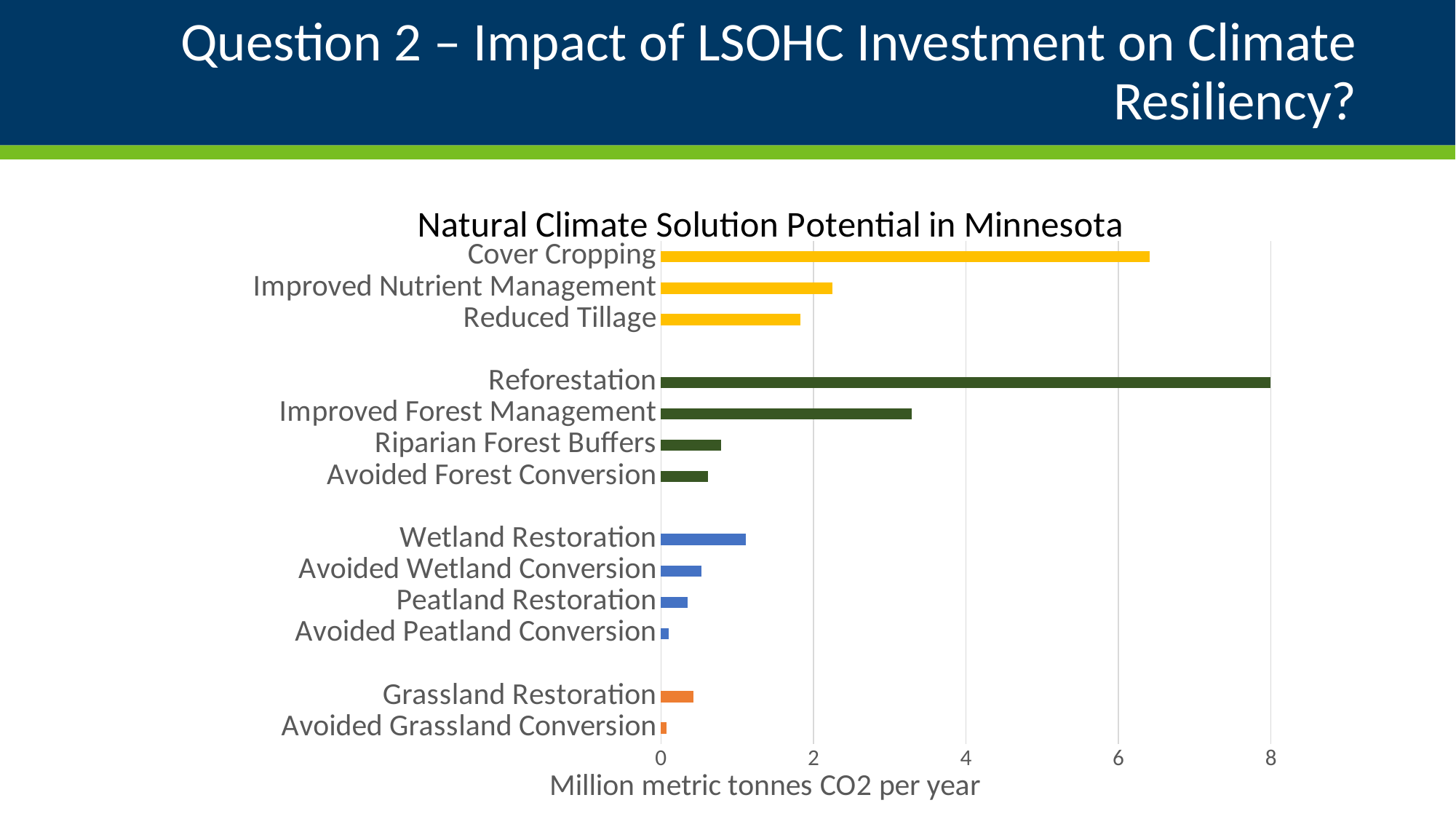
Which category has the lowest value in the chart? Avoided Grassland Conversion Which has a larger value, Wetland Restoration or Peatland Restoration? Wetland Restoration What kind of chart is shown on the slide? Bar chart How many categories are plotted in the chart? 13 Is the value for Cover Cropping greater or less than 6? greater Which category has the highest value in the chart? Reforestation What is the title of the chart? Natural Climate Solution Potential in Minnesota What is the label on the horizontal axis of the chart? Million metric tonnes CO2 per year Which has a larger value, Cover Cropping or Improved Forest Management? Cover Cropping Is the value for Improved Forest Management greater or less than 4? less Is the value for Riparian Forest Buffers greater or less than 2? less Which has a larger value, Grassland Restoration or Avoided Grassland Conversion? Grassland Restoration